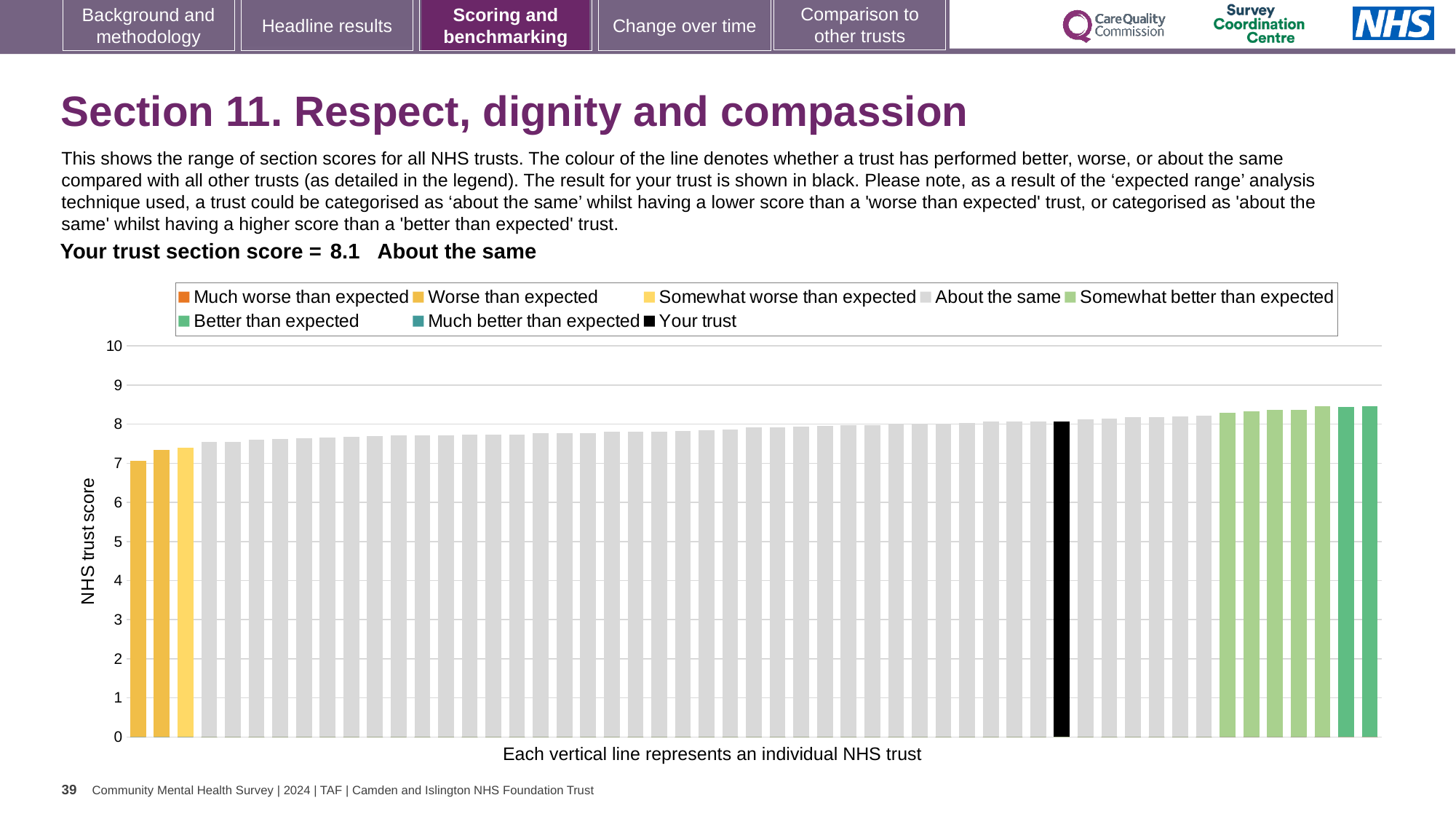
How many entries does the chart legend list? 8 Do the bar values rise or fall moving from left to right along the x axis? rise How many bars are coloured in the yellow 'worse than expected' shades? 3 What colour is used for the bar representing your trust? black Is the value of the rightmost (highest) bar greater or less than 9? less Which performance category is your trust placed in for Section 11? About the same Is the value of the leftmost (lowest) bar greater or less than 8? less Is the value of the rightmost bar greater or less than 8? greater What is the section score for your trust shown on the slide? 8.1 What type of chart is shown on the slide? bar chart Which is higher, the black bar for your trust or the leftmost bar? the black bar for your trust